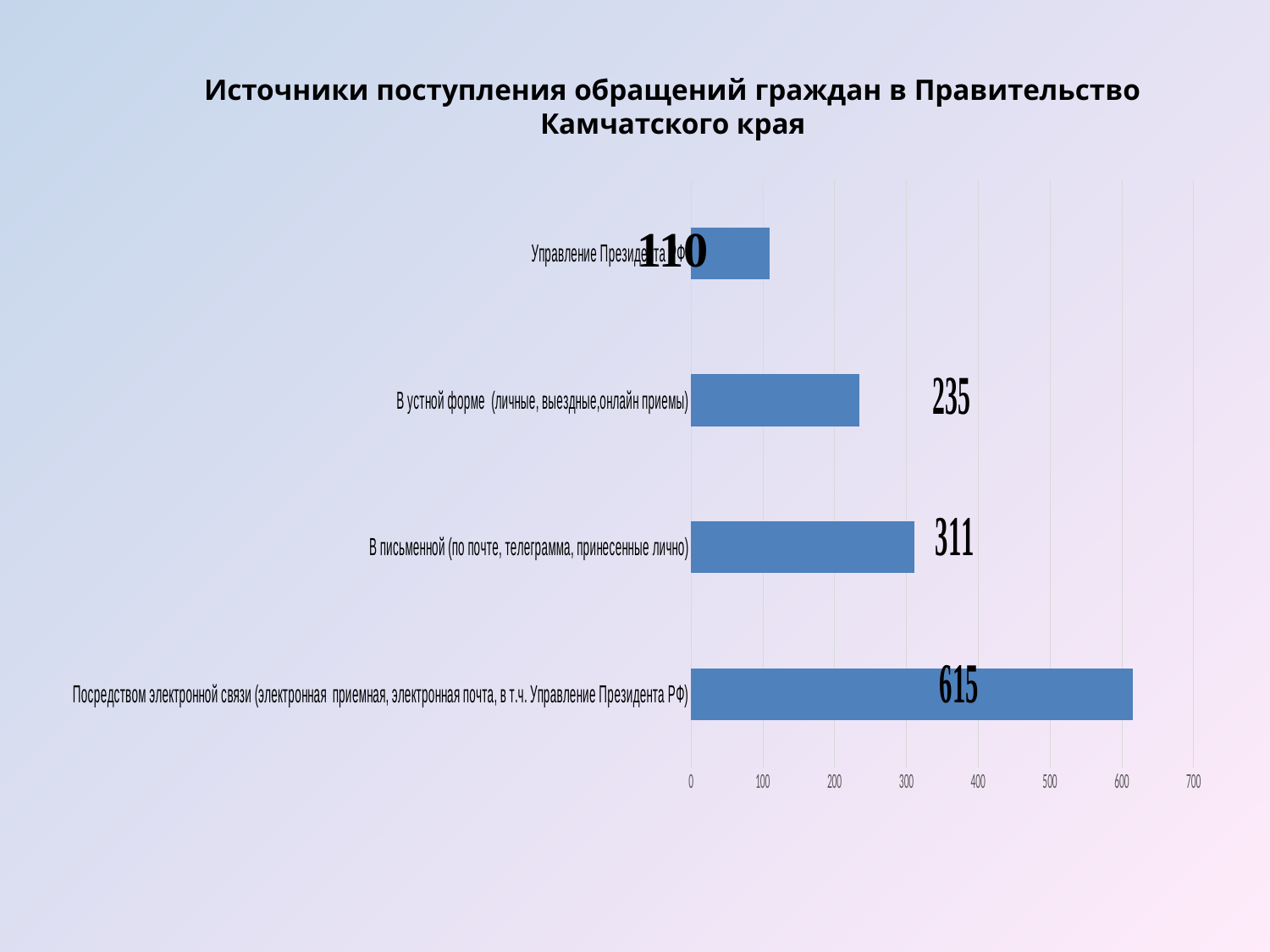
How many categories are plotted in the chart? 4 What is the difference between the values for "В письменной" and "В устной форме"? 76 What is the title of the chart? Источники поступления обращений граждан в Правительство Камчатского края Which category has the highest value? Посредством электронной связи (электронная приемная, электронная почта, в т.ч. Управление Президента РФ) What is the value for "Посредством электронной связи (электронная приемная, электронная почта, в т.ч. Управление Президента РФ)"? 615 Is the value for "Посредством электронной связи" greater or less than 600? greater What is the value for "В письменной (по почте, телеграмма, принесенные лично)"? 311 Which category has the lowest value? Управление Президента РФ What type of chart is shown on the slide? bar chart Which is larger: the value for "В устной форме" or the value for "Управление Президента РФ"? В устной форме What is the value for "Управление Президента РФ"? 110 What is the value for "В устной форме (личные, выездные, онлайн приемы)"? 235